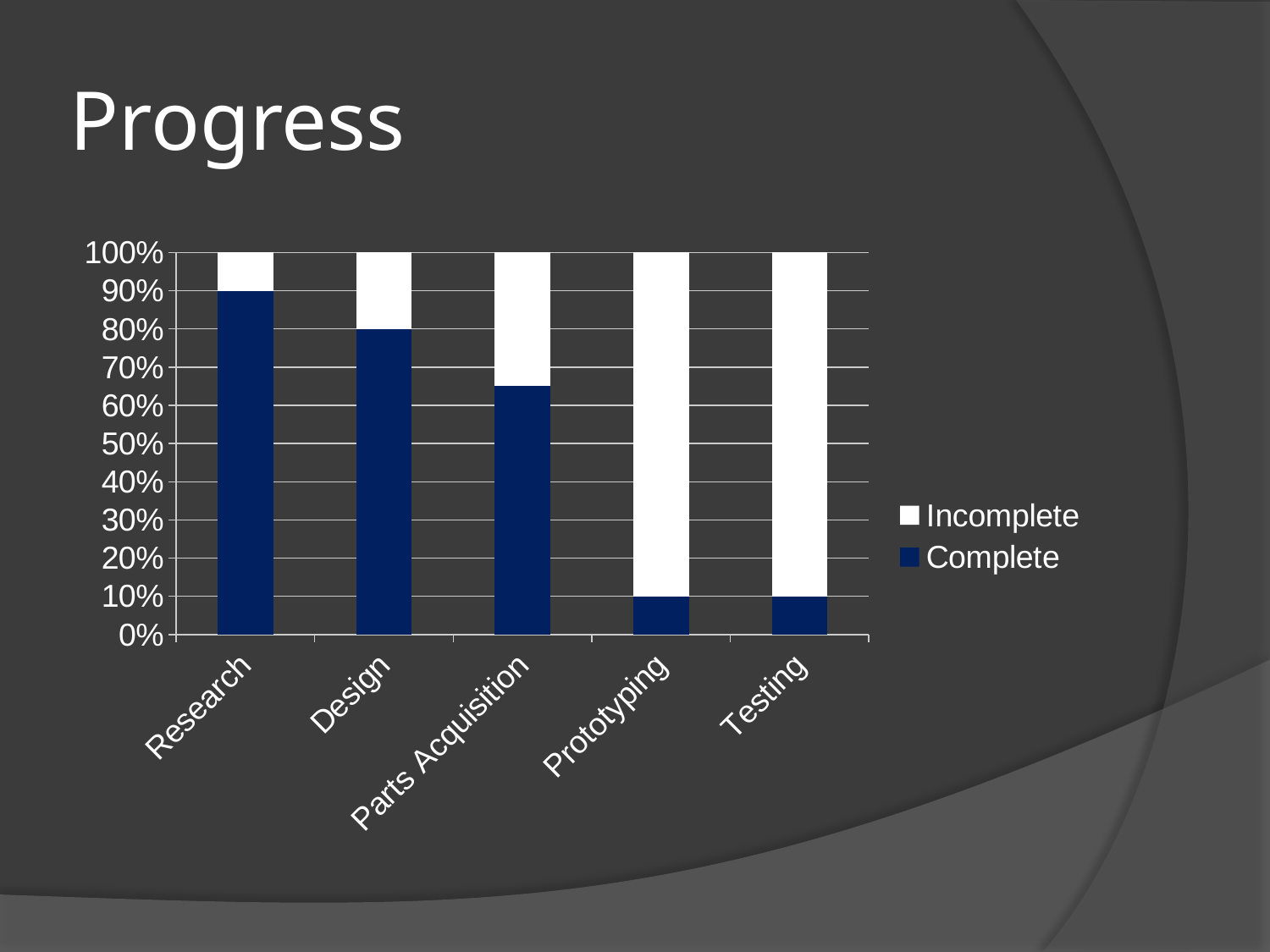
Which has a larger Complete value, Research or Design? Research What is the difference between the Complete values for Research and Design? 10% What is the title of the slide containing the chart? Progress Does the Complete value rise or fall from Research to Testing along the x axis? fall Which category has the highest Complete value? Research What is the Complete value for Prototyping? 10% What is the Complete value for Design? 80% How many categories are shown on the x axis of the chart? 5 What is the Complete value for Research? 90% What kind of chart is shown on the slide? bar chart Is the Complete value for Parts Acquisition greater or less than 60%? greater How many series does the legend list? 2